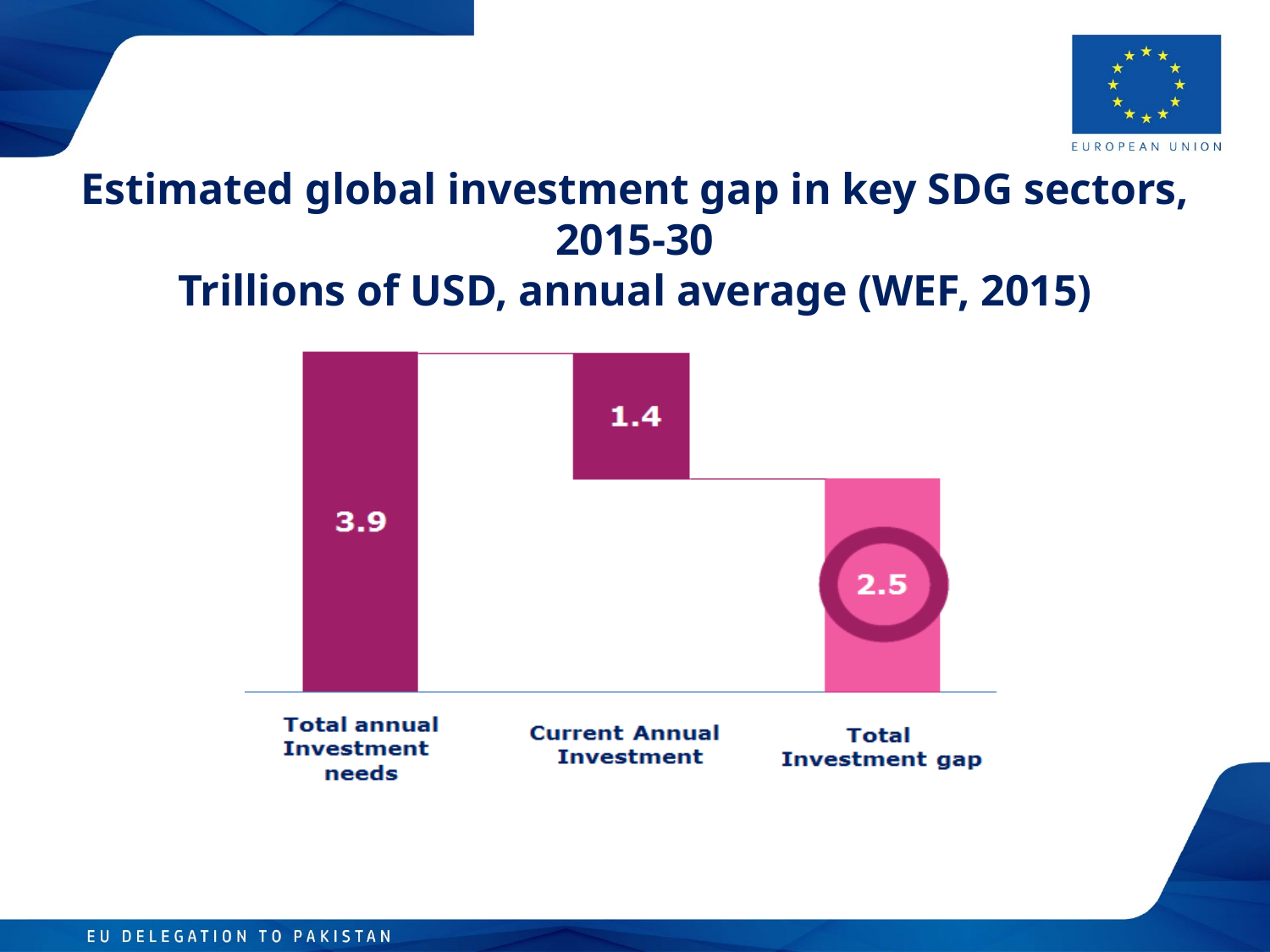
How many categories are shown on the chart? 3 What is the value for Current Annual Investment? 1.4 What kind of chart is shown on the slide? Bar chart Which category has the lowest value? Current Annual Investment What is the difference between Total Investment gap and Current Annual Investment? 1.1 Which is larger, Total Investment gap or Current Annual Investment? Total Investment gap Which value on the chart is highlighted with a circle? 2.5 Which category has the highest value? Total annual Investment needs In what units are the values on the chart expressed? Trillions of USD, annual average What is the difference between Total annual Investment needs and Current Annual Investment? 2.5 What is the value for Total Investment gap? 2.5 What is the value for Total annual Investment needs? 3.9